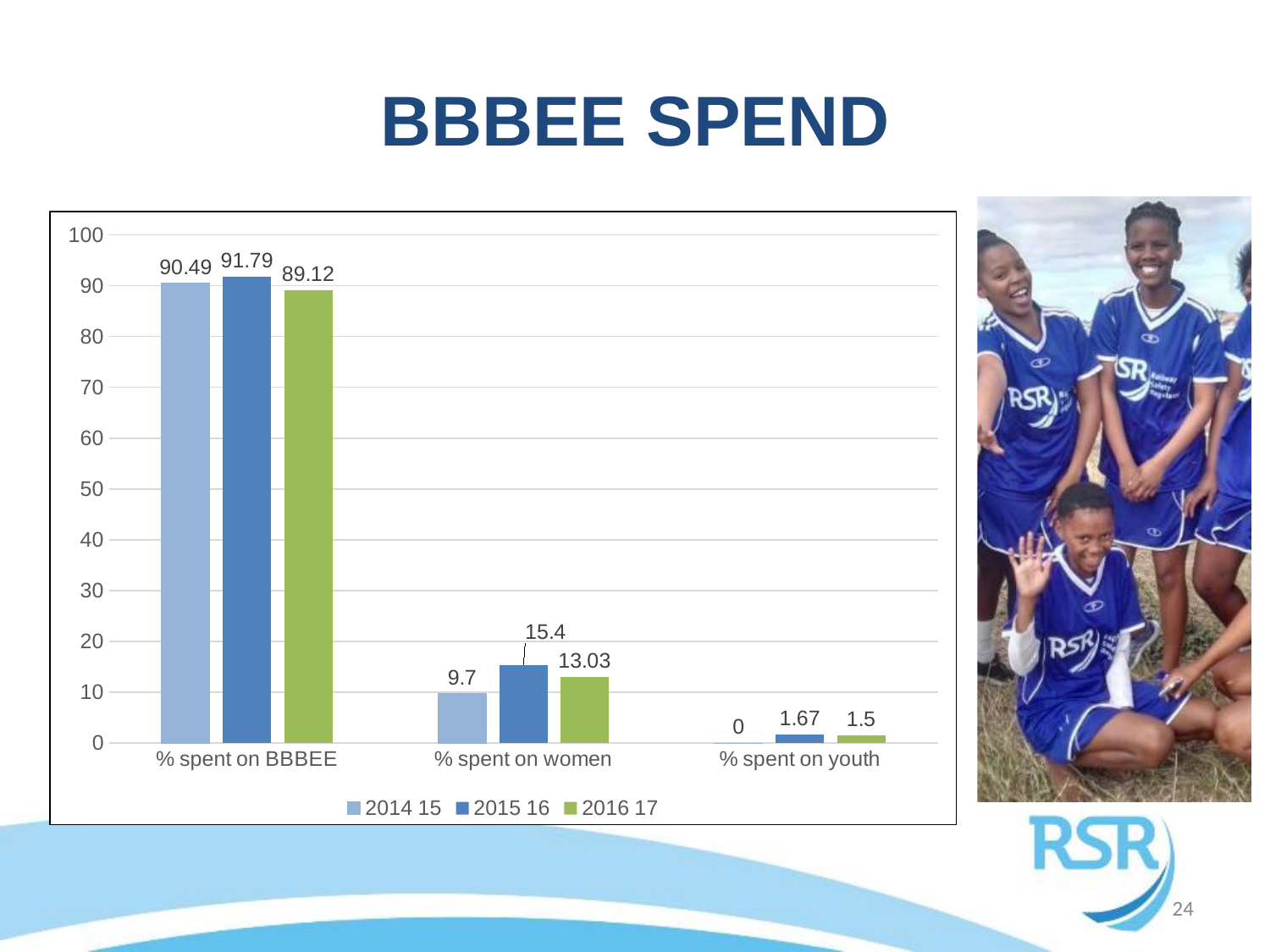
Which year has the lowest value for % spent on women? 2014 15 Which is larger: the 2016 17 value for % spent on BBBEE or the 2014 15 value for % spent on BBBEE? 2014 15 Which year has the highest value for % spent on BBBEE? 2015 16 What is the difference between the 2015 16 and 2014 15 values for % spent on women? 5.7 Is the value for % spent on women in 2015 16 greater or less than 20? less What is the value for % spent on youth in 2014 15? 0 What is the title of the slide containing the chart? BBBEE SPEND What is the value for % spent on women in 2016 17? 13.03 How many series does the legend list? 3 What kind of chart is shown on the slide? bar chart How many categories are shown on the x axis? 3 What is the value for % spent on BBBEE in 2015 16? 91.79